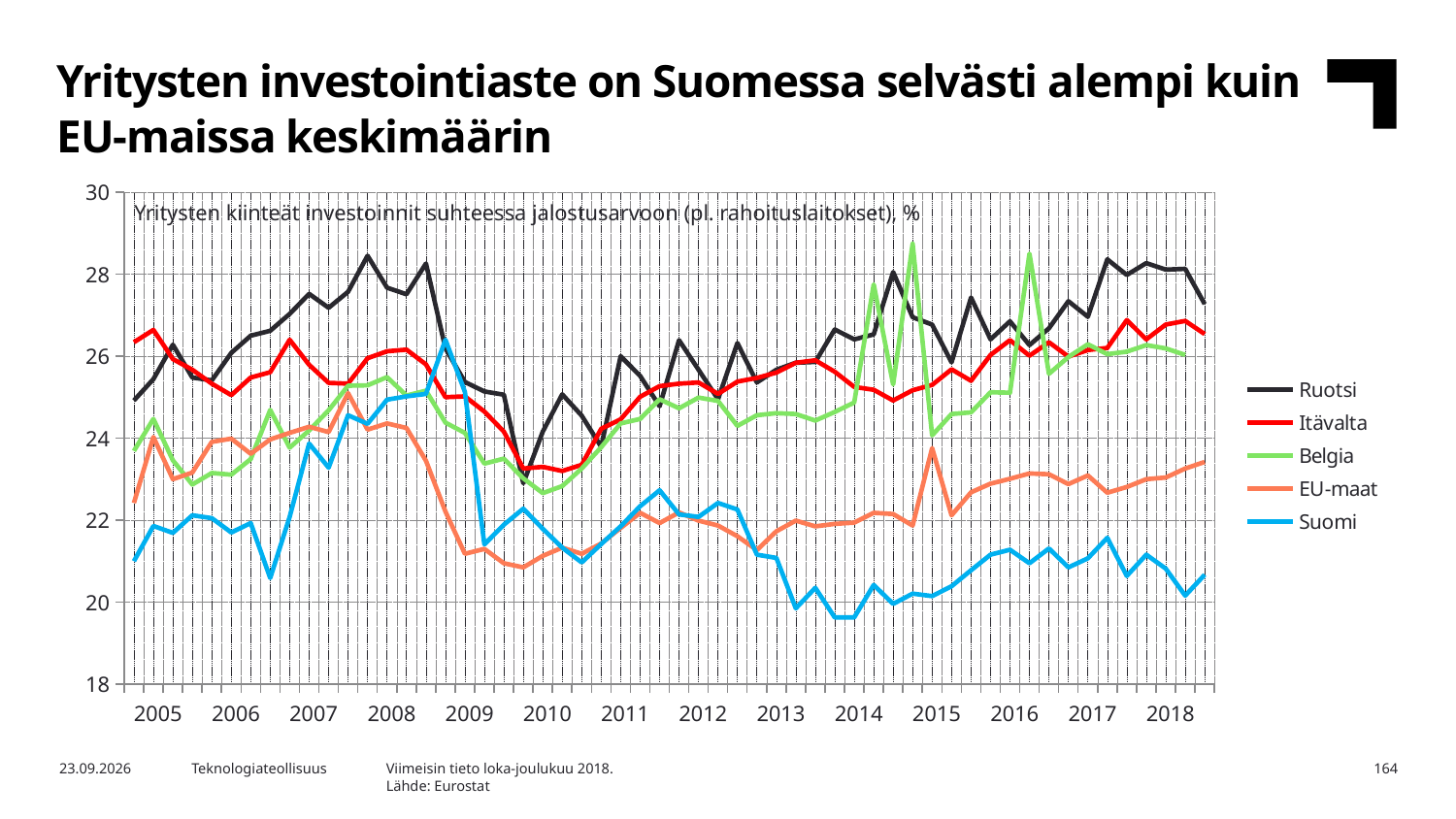
What is the text shown inside the chart area describing the plotted measure? Yritysten kiinteät investoinnit suhteessa jalostusarvoon (pl. rahoituslaitokset), % Which is larger in 2016, Itävalta or EU-maat? Itävalta Does the Suomi series rise or fall between 2012 and 2014? fall Is the value for Suomi in 2014 greater or less than 22? less Which series is the highest at the end of 2018? Ruotsi Does the Ruotsi series rise or fall between 2010 and 2018? rise Is the value for Ruotsi in 2017 greater or less than 26? greater How many series does the legend list? 5 What kind of chart is shown on the slide? line chart Is the value for Belgia in 2018 greater or less than 24? greater Which series is the lowest at the end of 2018? Suomi Which is larger in 2018, Ruotsi or Suomi? Ruotsi